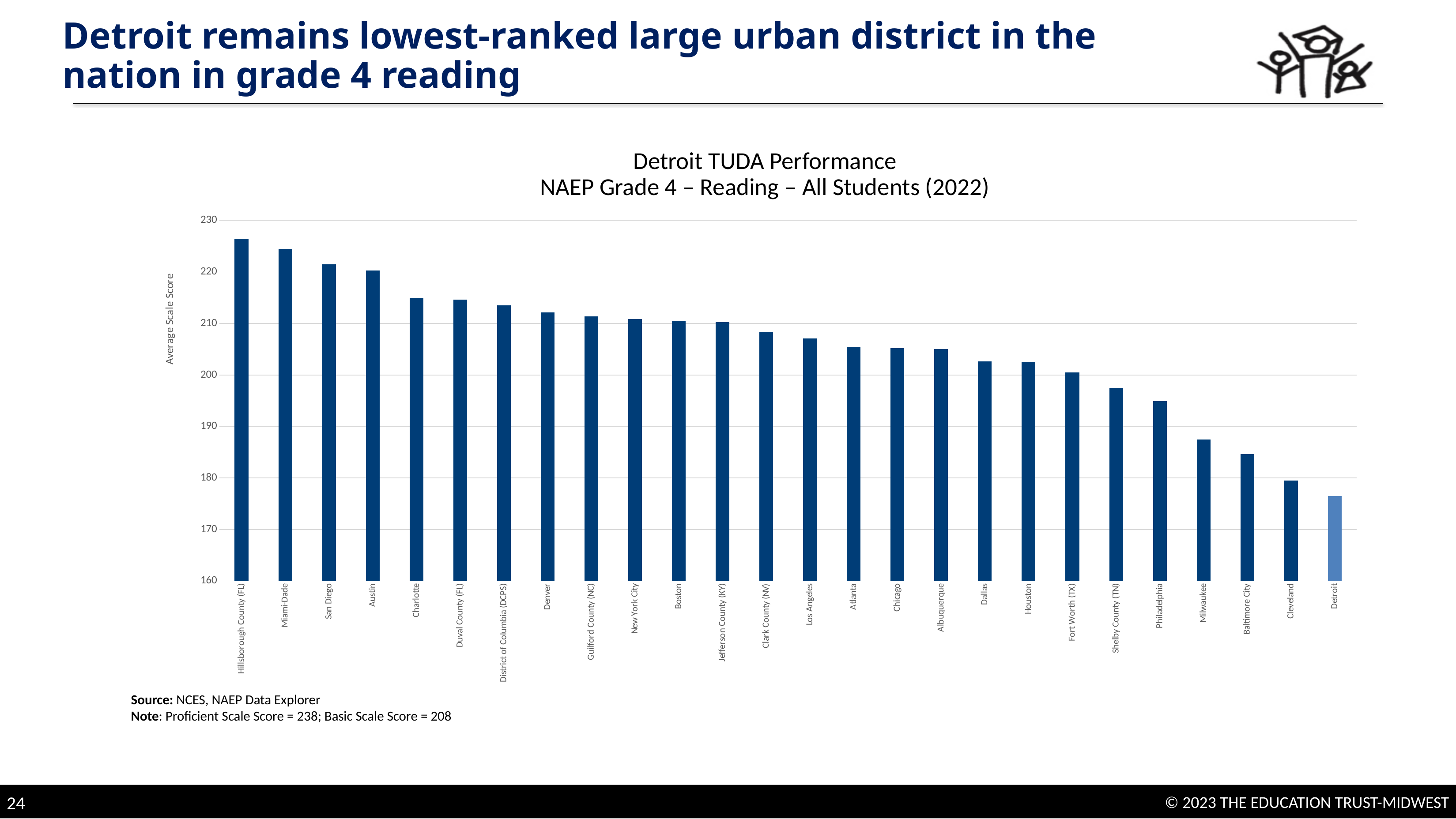
Which has a higher average scale score, Miami-Dade or San Diego? Miami-Dade What kind of chart is shown on the slide? bar chart Is the value for Detroit greater or less than 180? less What is the label on the vertical axis of the chart? Average Scale Score Is the value for Hillsborough County (FL) greater or less than 220? greater Is the value for Milwaukee greater or less than 190? less How many districts are plotted in the chart? 26 Which district has the highest average scale score? Hillsborough County (FL) Which district has the lowest average scale score? Detroit Do the values rise or fall moving from left to right along the x axis? fall